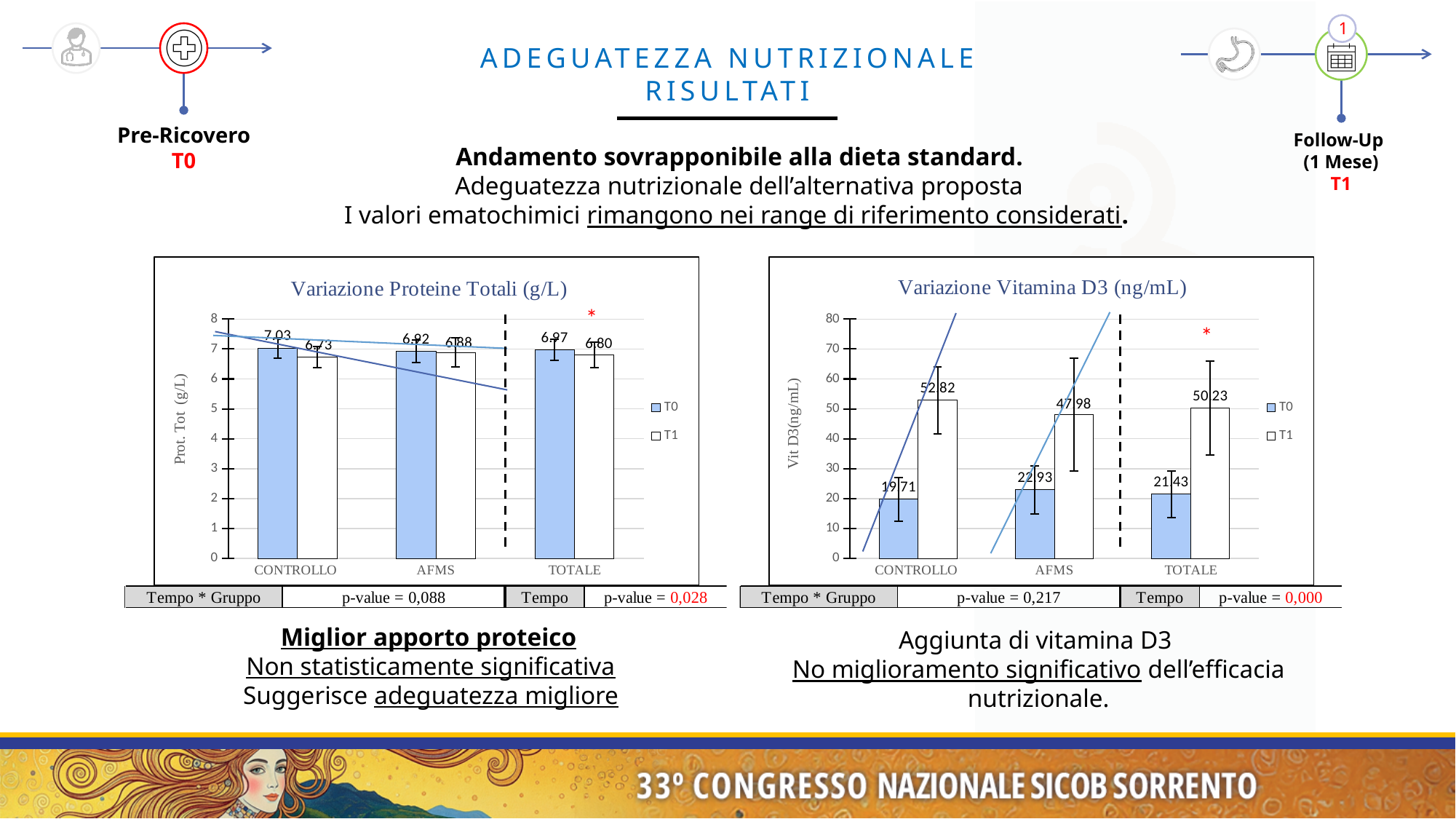
In the 'Variazione Proteine Totali (g/L)' chart, what is the T0 value for CONTROLLO? 7,03 How many groups are shown on the x axis of the 'Variazione Proteine Totali (g/L)' chart? 3 In the 'Variazione Vitamina D3 (ng/mL)' chart, what is the T1 value for CONTROLLO? 52,82 In the 'Variazione Vitamina D3 (ng/mL)' chart, which group has the highest T1 value? CONTROLLO In the 'Variazione Vitamina D3 (ng/mL)' chart, what is the difference between the T1 and T0 values for TOTALE? 28,80 What type of chart is 'Variazione Proteine Totali (g/L)'? Bar chart In the 'Variazione Vitamina D3 (ng/mL)' chart, which group has the lowest T0 value? CONTROLLO How many series does the legend of the 'Variazione Vitamina D3 (ng/mL)' chart list? 2 In the 'Variazione Proteine Totali (g/L)' chart, what is the T0 value for TOTALE? 6,97 In the 'Variazione Vitamina D3 (ng/mL)' chart, what is the T0 value for AFMS? 22,93 In the 'Variazione Vitamina D3 (ng/mL)' chart, is the T1 value for TOTALE greater or less than 40? greater In the 'Variazione Vitamina D3 (ng/mL)' chart, which is larger for AFMS, the T0 value or the T1 value? T1